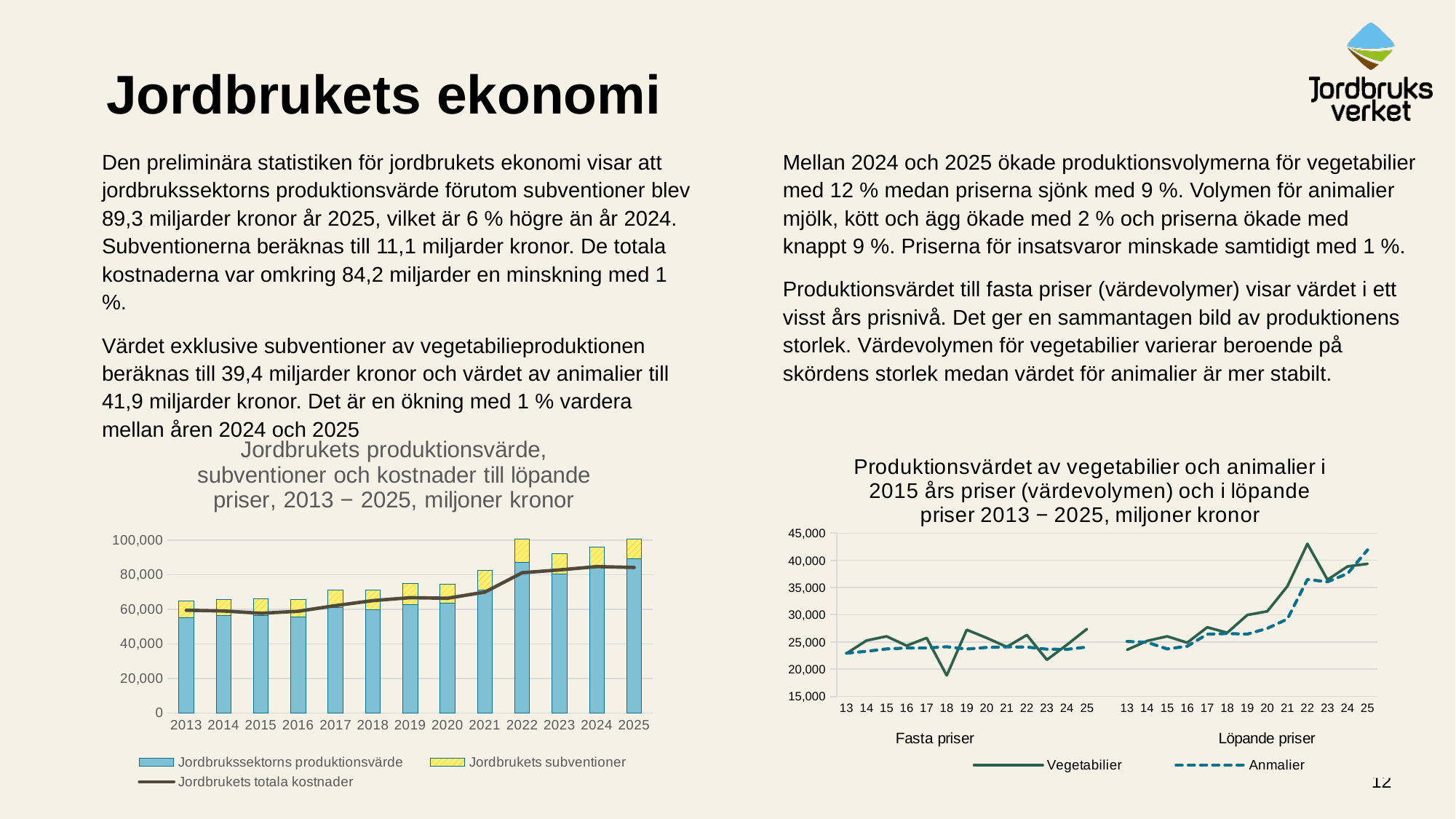
In the left chart, is the value of Jordbrukssektorns produktionsvärde for 2022 greater or less than 80,000? greater In the left chart, how many series does the legend list? 3 In the right chart, how many series does the legend list? 2 In the left chart, is the value of Jordbrukets totala kostnader for 2025 greater or less than 80,000? greater In the right chart, in the Löpande priser panel, is the value for Vegetabilier in year 22 greater or less than 40,000? greater What kind of chart is the left chart, 'Jordbrukets produktionsvärde, subventioner och kostnader till löpande priser'? Bar chart (stacked bars with a line) In the left chart, does Jordbrukssektorns produktionsvärde generally rise or fall from 2013 to 2025? rise In the right chart, in the Löpande priser panel, which series has the higher value in year 22, Vegetabilier or Anmalier? Vegetabilier In the right chart, in the Löpande priser panel, in which year is Vegetabilier at its highest? 22 In the left chart, how many years are shown on the x axis? 13